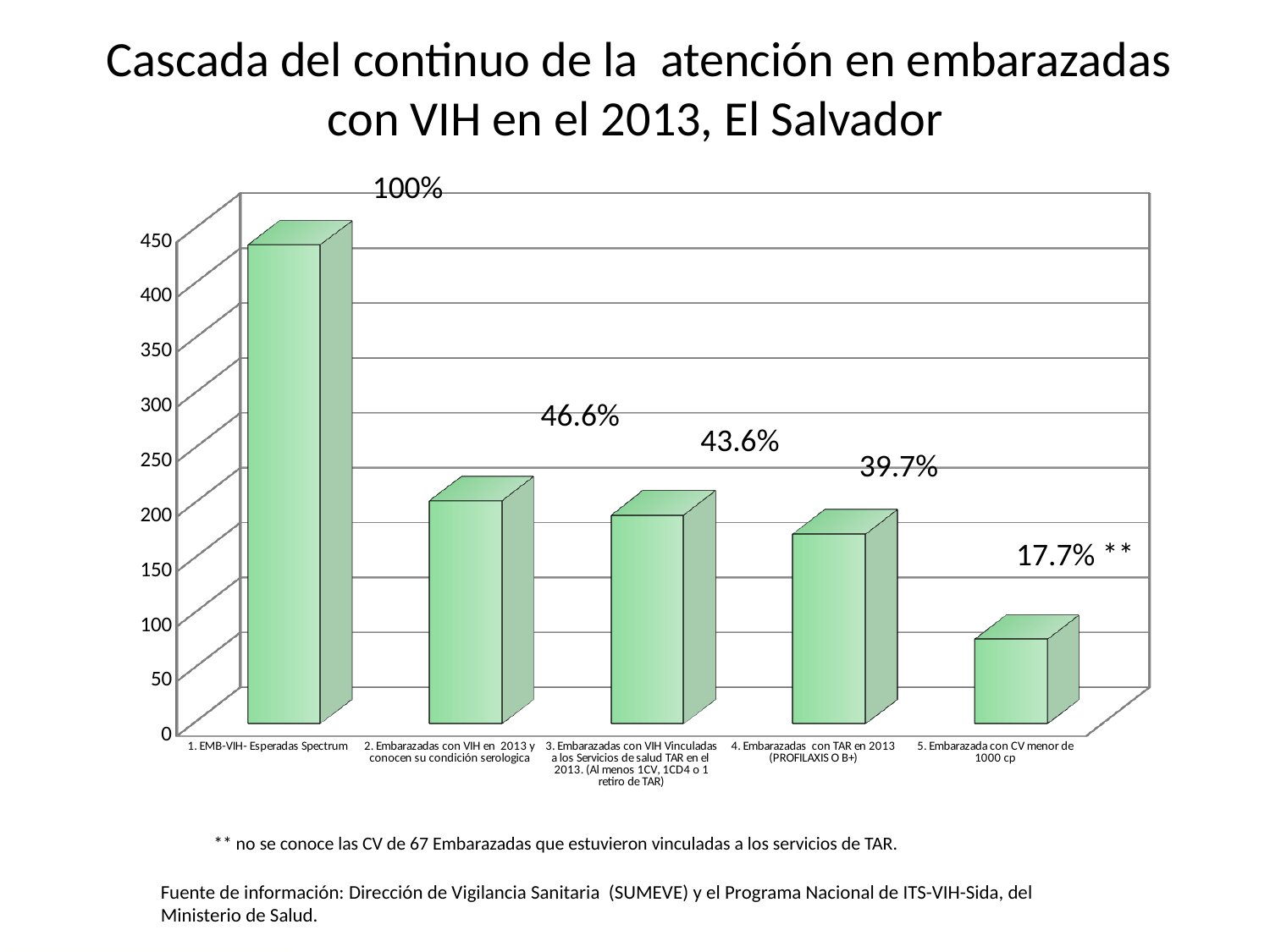
Is the value for '1. EMB-VIH- Esperadas Spectrum' greater or less than 400? greater Which category has the tallest bar? 1. EMB-VIH- Esperadas Spectrum What percentage label is shown above the bar for '1. EMB-VIH- Esperadas Spectrum'? 100% What percentage label is shown above the bar for '5. Embarazada con CV menor de 1000 cp'? 17.7% Is the value for '5. Embarazada con CV menor de 1000 cp' greater or less than 100? less What percentage label is shown above the bar for '4. Embarazadas con TAR en 2013 (PROFILAXIS O B+)'? 39.7% What is the difference in percentage points between the labels for category 2 (46.6%) and category 3 (43.6%)? 3 percentage points What kind of chart is shown on the slide? Bar chart What percentage label is shown above the bar for '2. Embarazadas con VIH en 2013 y conocen su condición serologica'? 46.6% Do the bar values rise or fall from left to right along the x axis? Fall How many categories (bars) are shown in the chart? 5 Which category has the shortest bar? 5. Embarazada con CV menor de 1000 cp